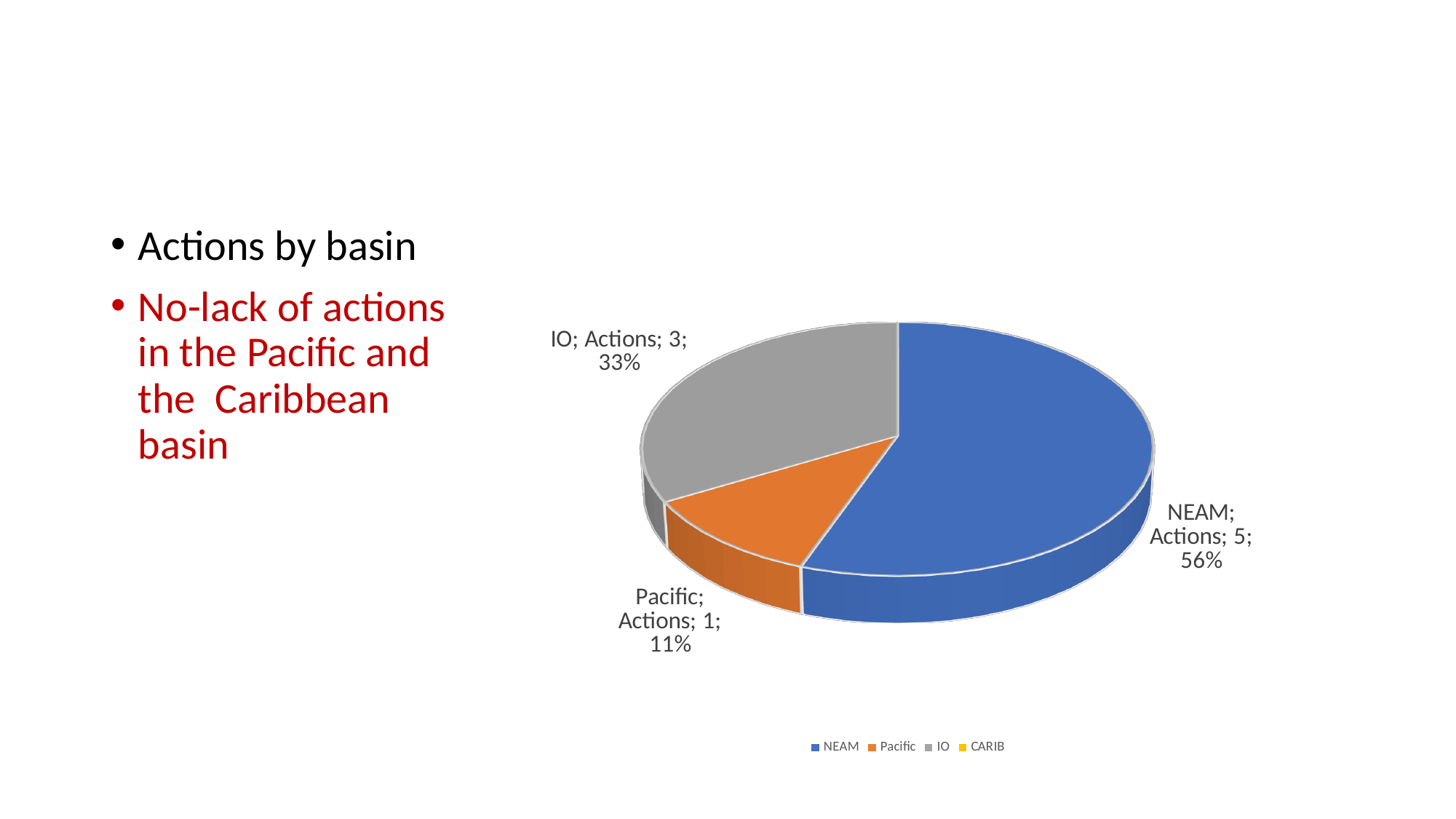
Which has more Actions, IO or Pacific? IO What share of the pie does the Pacific slice take? 11% What share of the pie does the IO slice take? 33% Which basin has the highest number of Actions? NEAM Which basin with a visible slice has the lowest number of Actions? Pacific What share of the pie does the NEAM slice take? 56% How many entries does the legend list? 4 How many Actions does the IO slice represent? 3 What kind of chart is shown on the slide? pie chart How many Actions does the Pacific slice represent? 1 What is the difference in Actions between NEAM and IO? 2 How many Actions does the NEAM slice represent? 5